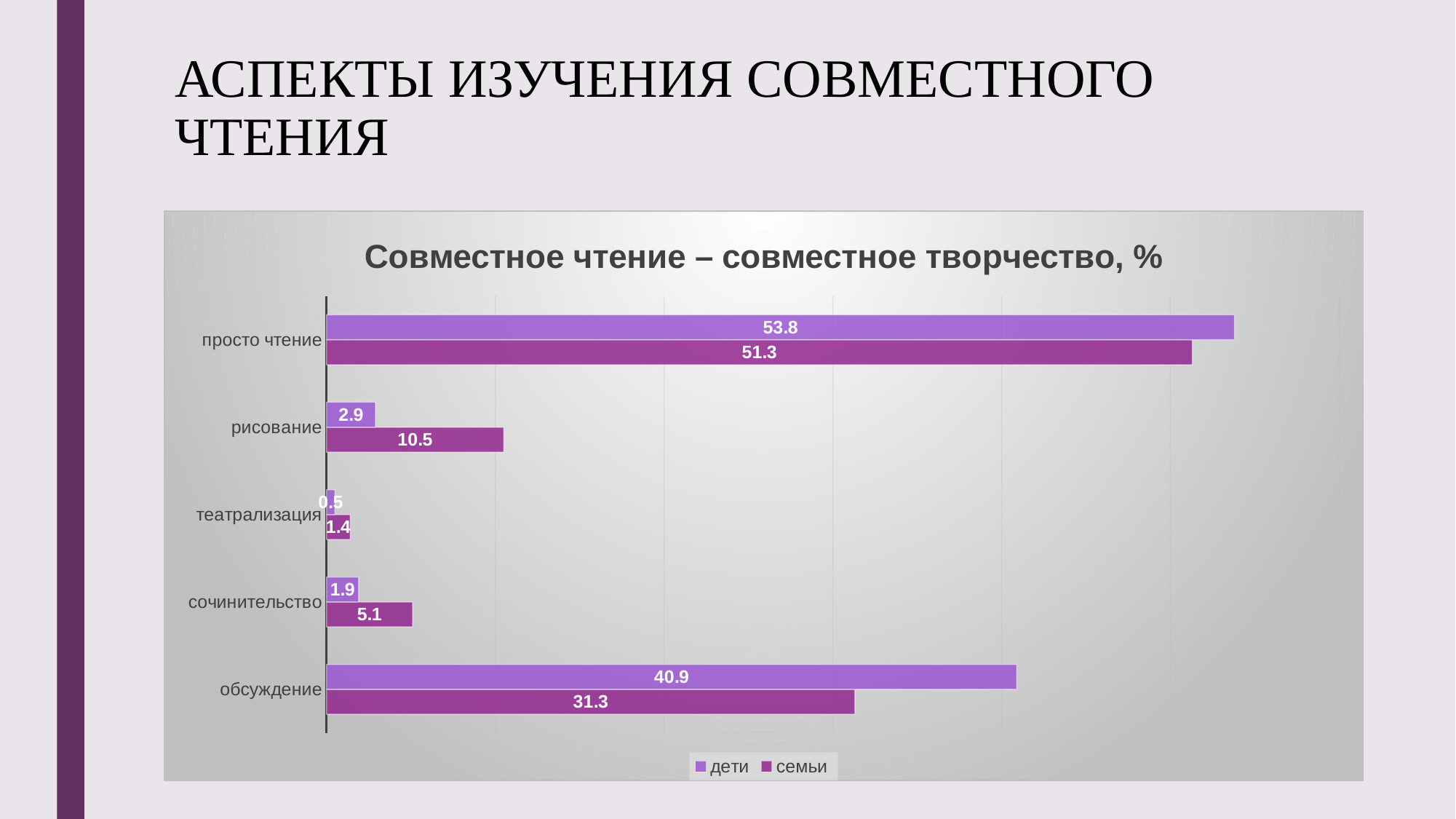
What is the value for семьи in the обсуждение category? 31.3 What is the title of the chart? Совместное чтение – совместное творчество, % How many series does the legend list? 2 What is the difference between the дети and семьи values for обсуждение? 9.6 Which category has the lowest value for the семьи series? театрализация What kind of chart is shown on the slide? bar chart What is the value for семьи in the рисование category? 10.5 Which is larger for рисование: the дети value or the семьи value? семьи Which category has the highest value for the дети series? просто чтение How many categories are shown on the chart? 5 What is the value for дети in the просто чтение category? 53.8 What is the value for дети in the сочинительство category? 1.9